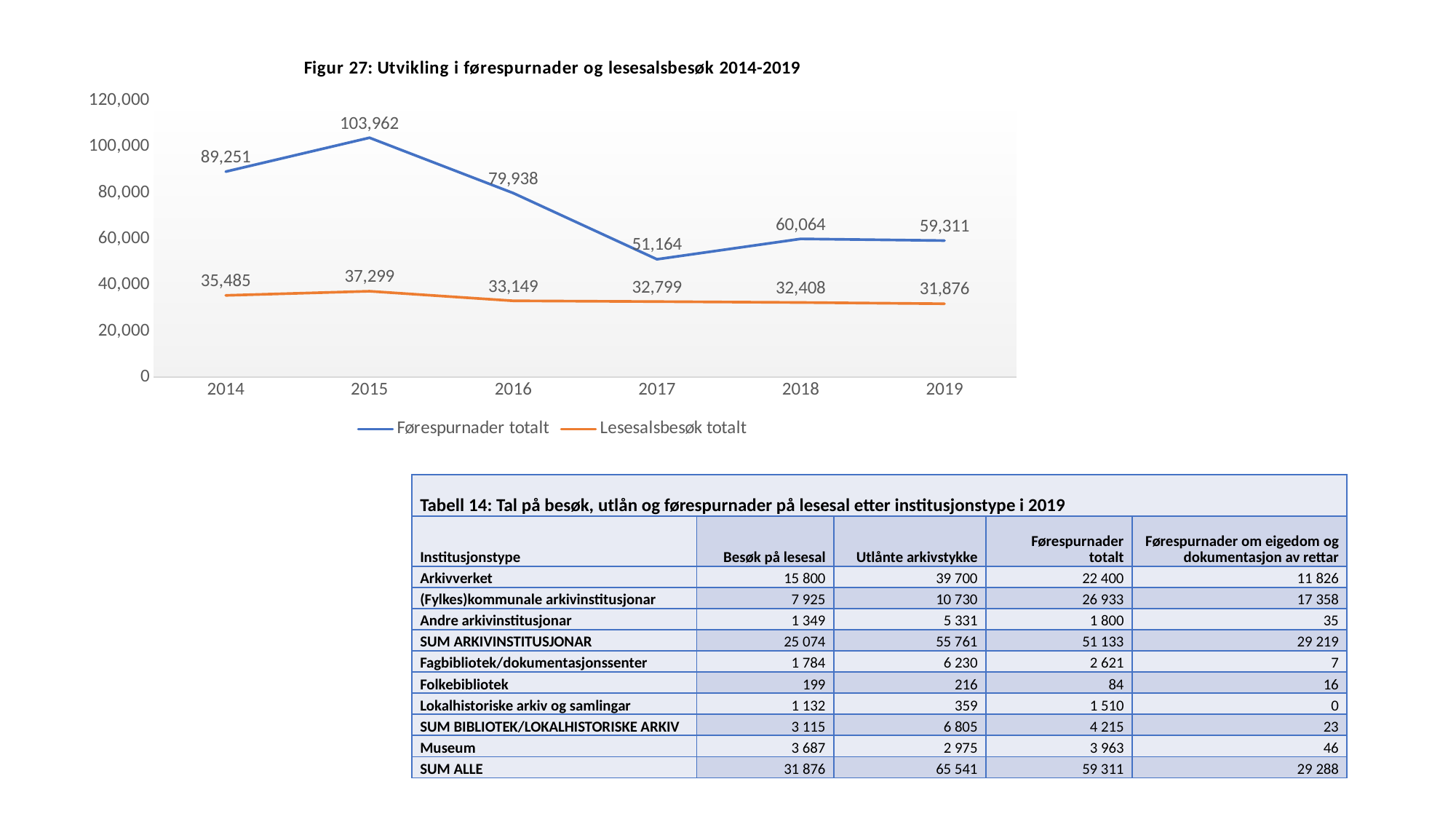
In which year is Lesesalsbesøk totalt highest? 2015 How many years are shown on the x axis of the chart? 6 What is the value of Førespurnader totalt in 2017? 51,164 What kind of chart is Figur 27? Line chart By how much did Førespurnader totalt increase from 2014 to 2015? 14,711 In which year is Førespurnader totalt lowest? 2017 In which year is Førespurnader totalt highest? 2015 What is the value of Førespurnader totalt in 2015? 103,962 What is the difference between Førespurnader totalt and Lesesalsbesøk totalt in 2015? 66,663 What is the value of Lesesalsbesøk totalt in 2019? 31,876 How many series does the chart legend list? 2 Which is larger in 2018: Førespurnader totalt or Lesesalsbesøk totalt? Førespurnader totalt